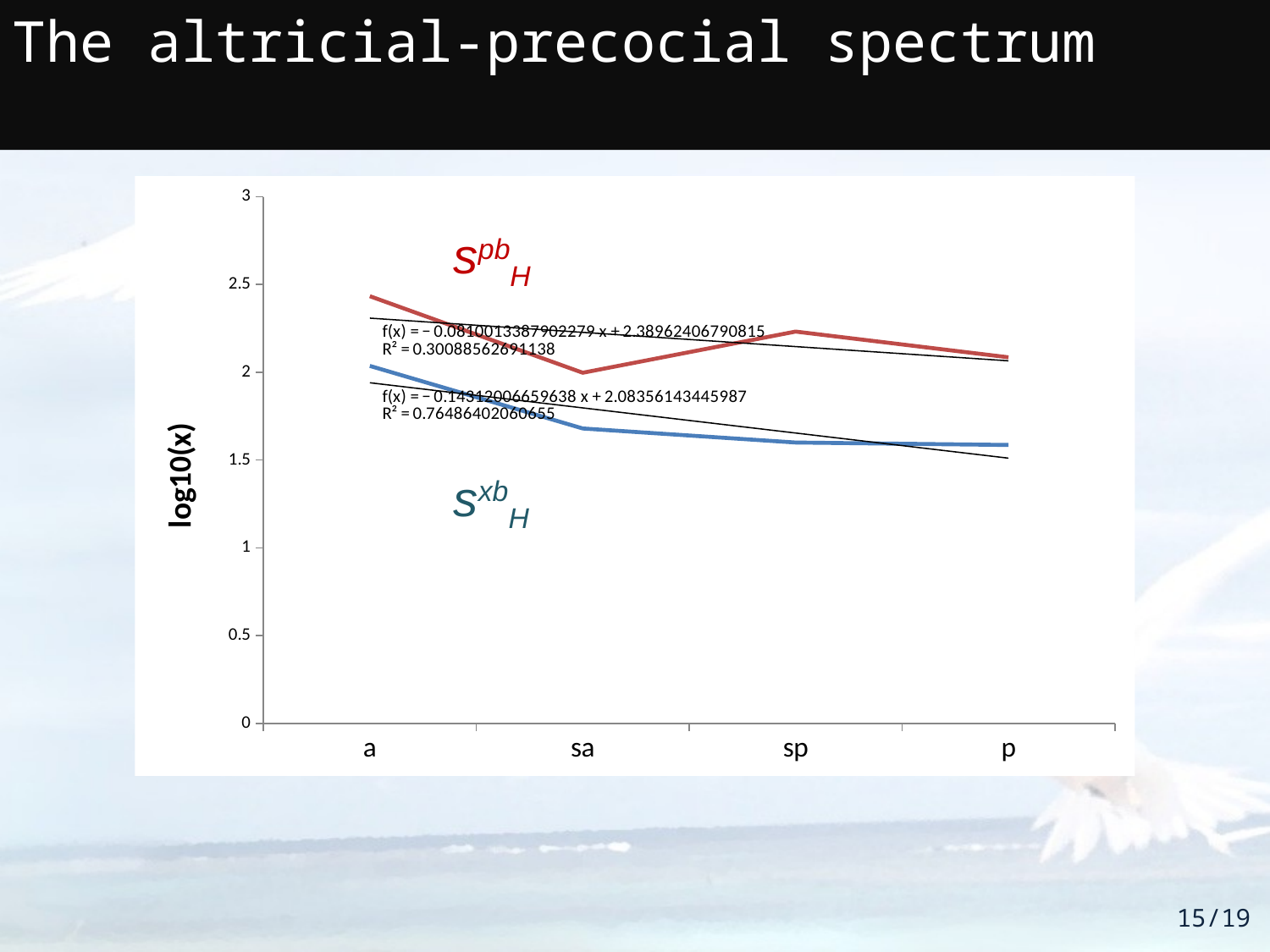
How many categories are shown on the x axis? 4 What kind of chart is shown on the slide? line chart For the blue S^xb_H series, at which x-axis category is the value highest? a What is the label on the y axis? log10(x) Is the value of the red S^pb_H series at 'a' greater or less than 2? greater Is the value of the blue S^xb_H series at 'sa' greater or less than 2? less At category 'p', which series has the larger value, the red S^pb_H or the blue S^xb_H? red S^pb_H Does the blue S^xb_H series rise or fall from 'a' to 'p' along the x axis? fall How many data series (coloured lines) are plotted on the chart? 2 For the red S^pb_H series, at which x-axis category is the value highest? a What R² value is printed for the trendline of the blue S^xb_H series? 0.76486402060655 Is the value of the red S^pb_H series at 'sp' greater or less than 2? greater